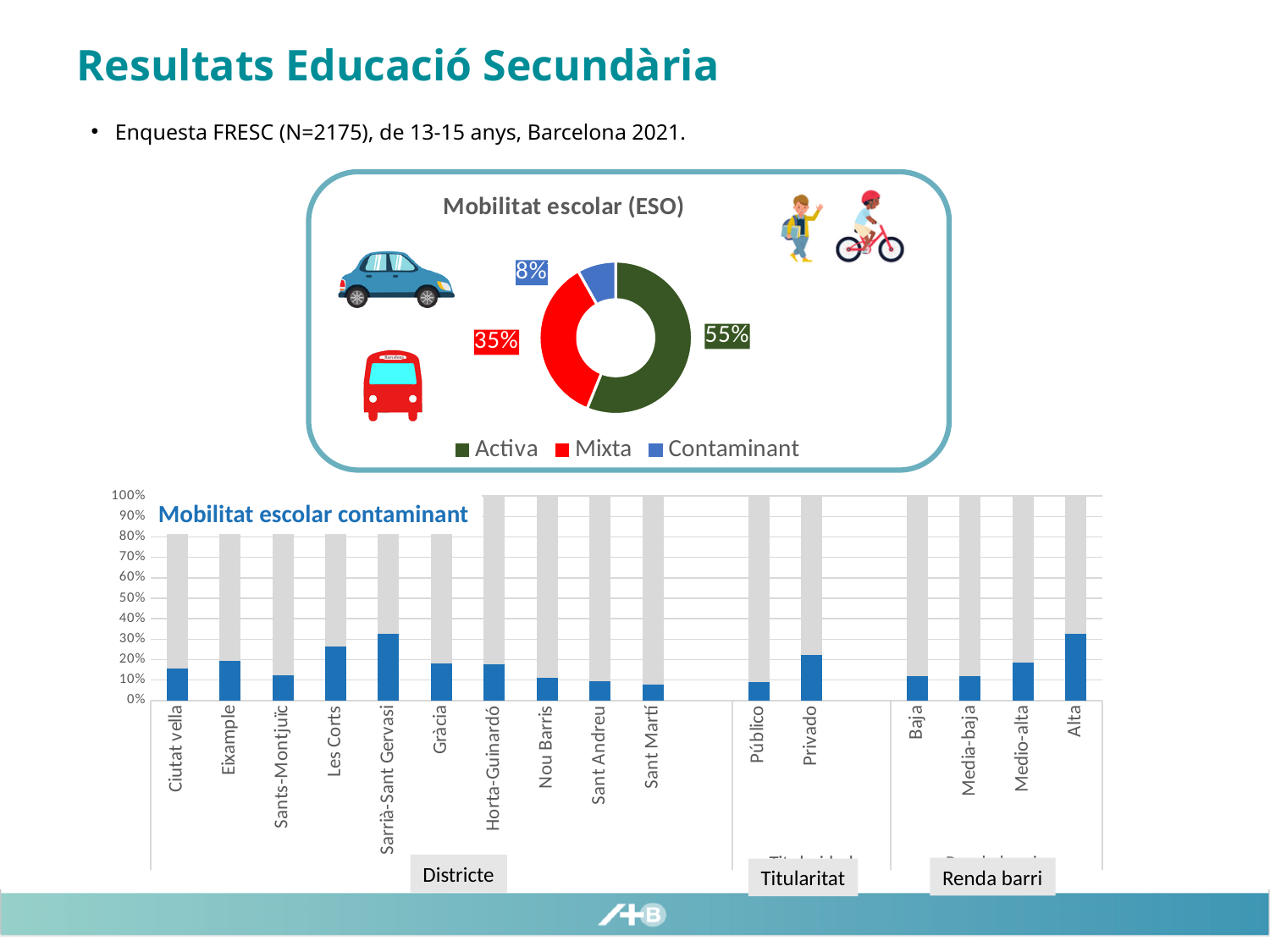
In the 'Mobilitat escolar (ESO)' donut chart, which category has the largest share? Activa What kind of chart is 'Mobilitat escolar contaminant'? Bar chart In the 'Mobilitat escolar (ESO)' donut chart, what percentage is shown for Mixta? 35% In the 'Mobilitat escolar contaminant' chart, is the value for Les Corts greater or less than 20%? greater In the 'Mobilitat escolar contaminant' chart, which district has the highest value? Sarrià-Sant Gervasi In the 'Mobilitat escolar contaminant' chart, how many districts are shown in the Districte group? 10 In the 'Mobilitat escolar (ESO)' donut chart, how many percentage points larger is Activa than Mixta? 20 percentage points In the 'Mobilitat escolar (ESO)' donut chart, what percentage is shown for Contaminant? 8% In the 'Mobilitat escolar (ESO)' donut chart, what percentage is shown for Activa? 55% In the 'Mobilitat escolar contaminant' chart, which is larger, Público or Privado? Privado How many entries does the legend of the 'Mobilitat escolar (ESO)' chart list? 3 In the 'Mobilitat escolar (ESO)' donut chart, which category has the smallest share? Contaminant